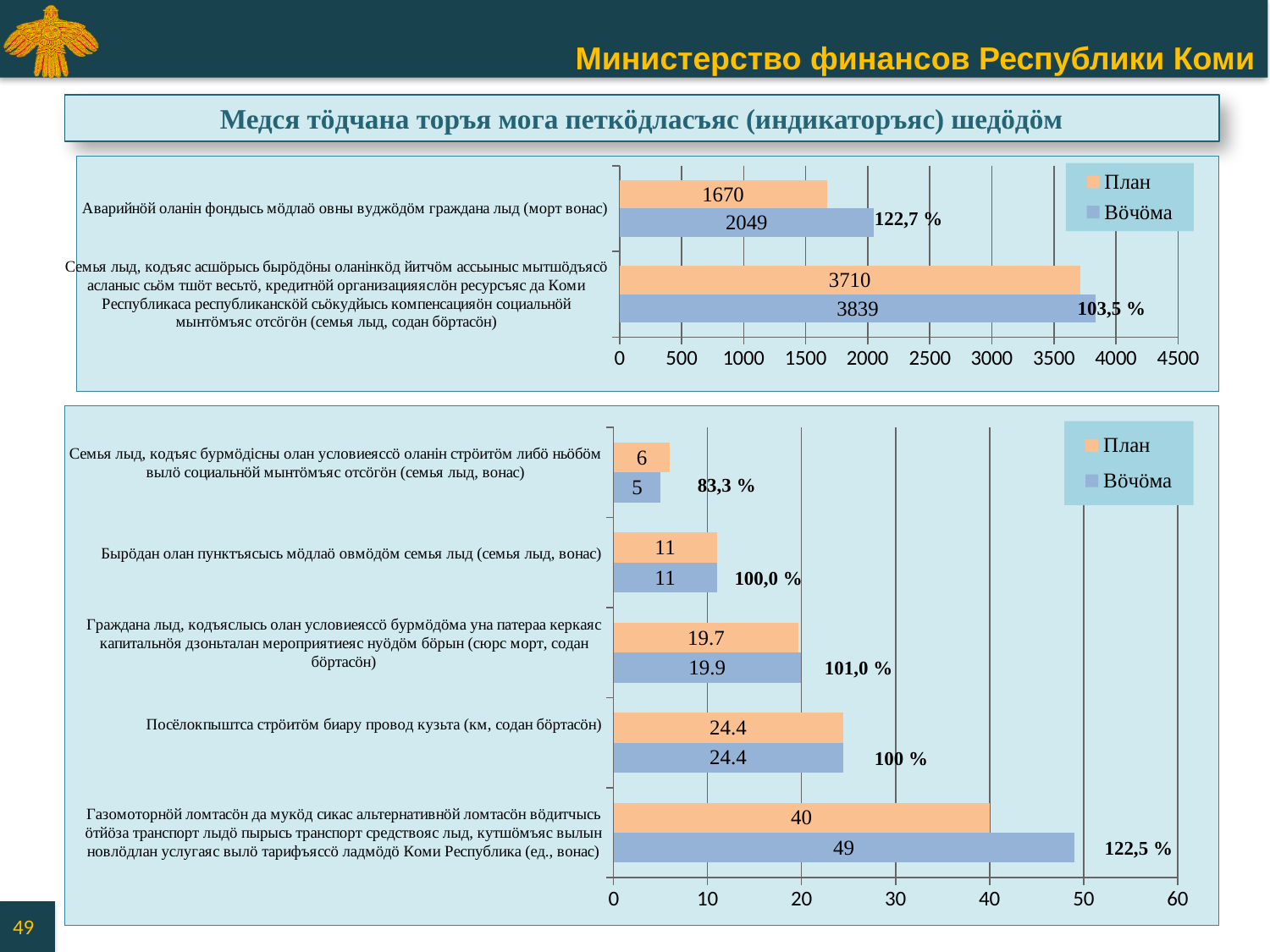
How many series does the legend of the top chart list? 2 In the bottom chart, what is the План value for the category beginning "Граждана лыд, кодъяслысь"? 19.7 In the top chart, what is the difference between the Вöчöма and План values for the category beginning "Аварийнöй оланiн фондысь"? 379 In the bottom chart, which category has the lowest Вöчöма value? Семья лыд, кодъяс бурмöдiсны олан условиеяссö оланiн стрöитöм либö ньöбöм вылö социальнöй мынтöмъяс отсöгöн In the bottom chart, what is the Вöчöма value for the category beginning "Газомоторнöй ломтасöн"? 49 In the bottom chart, what percentage label is shown next to the category beginning "Газомоторнöй ломтасöн"? 122,5 % What kind of chart is the bottom chart? bar chart In the top chart, what is the План value for the category beginning "Аварийнöй оланiн фондысь"? 1670 In the top chart, which category has the higher Вöчöма value? Семья лыд, кодъяс асшöрысь бырöдöны оланiнкöд йитчöм ассьыныс мытшöдъясö... In the top chart, what is the Вöчöма value for the category beginning "Семья лыд, кодъяс асшöрысь"? 3839 In the bottom chart, is the План value larger or the Вöчöма value larger for the category beginning "Семья лыд, кодъяс бурмöдiсны"? План How many categories are shown in the bottom chart? 5